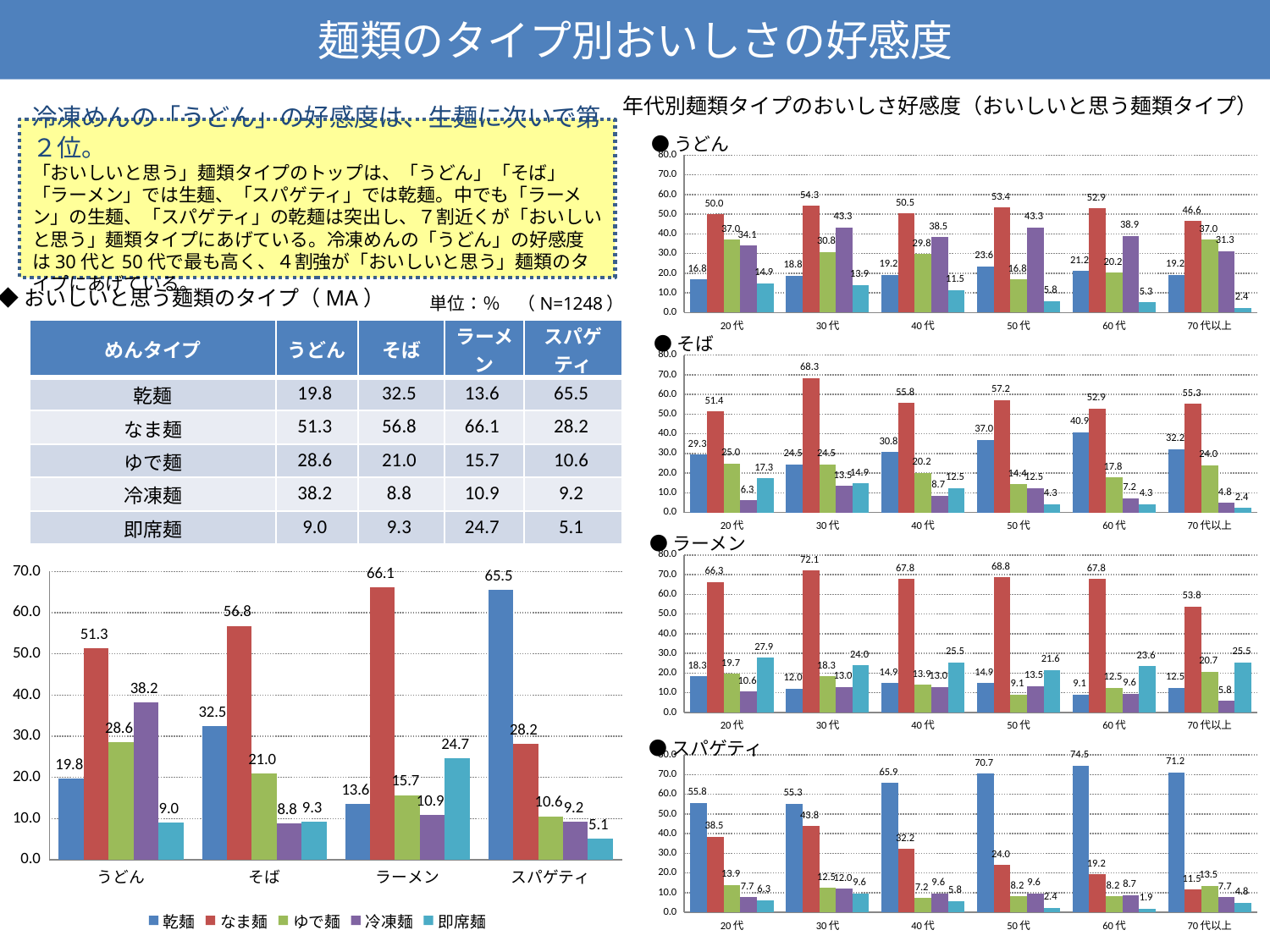
How many series does the legend of the bottom-left bar chart list? 5 In the スパゲティ chart on the right (年代別), which age group has the highest value for the tallest (blue) series? 60代 In the bottom-left bar chart, what is the value for 乾麺 in the スパゲティ category? 65.5 In the bottom-left bar chart, which series has the lowest value in the そば category? 冷凍麺 In the bottom-left bar chart, what is the difference between なま麺 and 乾麺 in the そば category? 24.3 In the うどん chart on the right (年代別), what is the highest value shown for the 30代 group? 54.3 In the bottom-left bar chart (おいしいと思う麺類のタイプ), what is the value for なま麺 in the ラーメン category? 66.1 In the ラーメン chart on the right (年代別), is the highest value for 30代 greater or less than 70.0? greater What kind of chart is the bottom-left chart? bar chart How many categories are shown on the x axis of the bottom-left bar chart? 4 In the bottom-left bar chart, which series has the highest value in the うどん category? なま麺 In the bottom-left bar chart, which is larger: 冷凍麺 for うどん or 即席麺 for ラーメン? 冷凍麺 for うどん